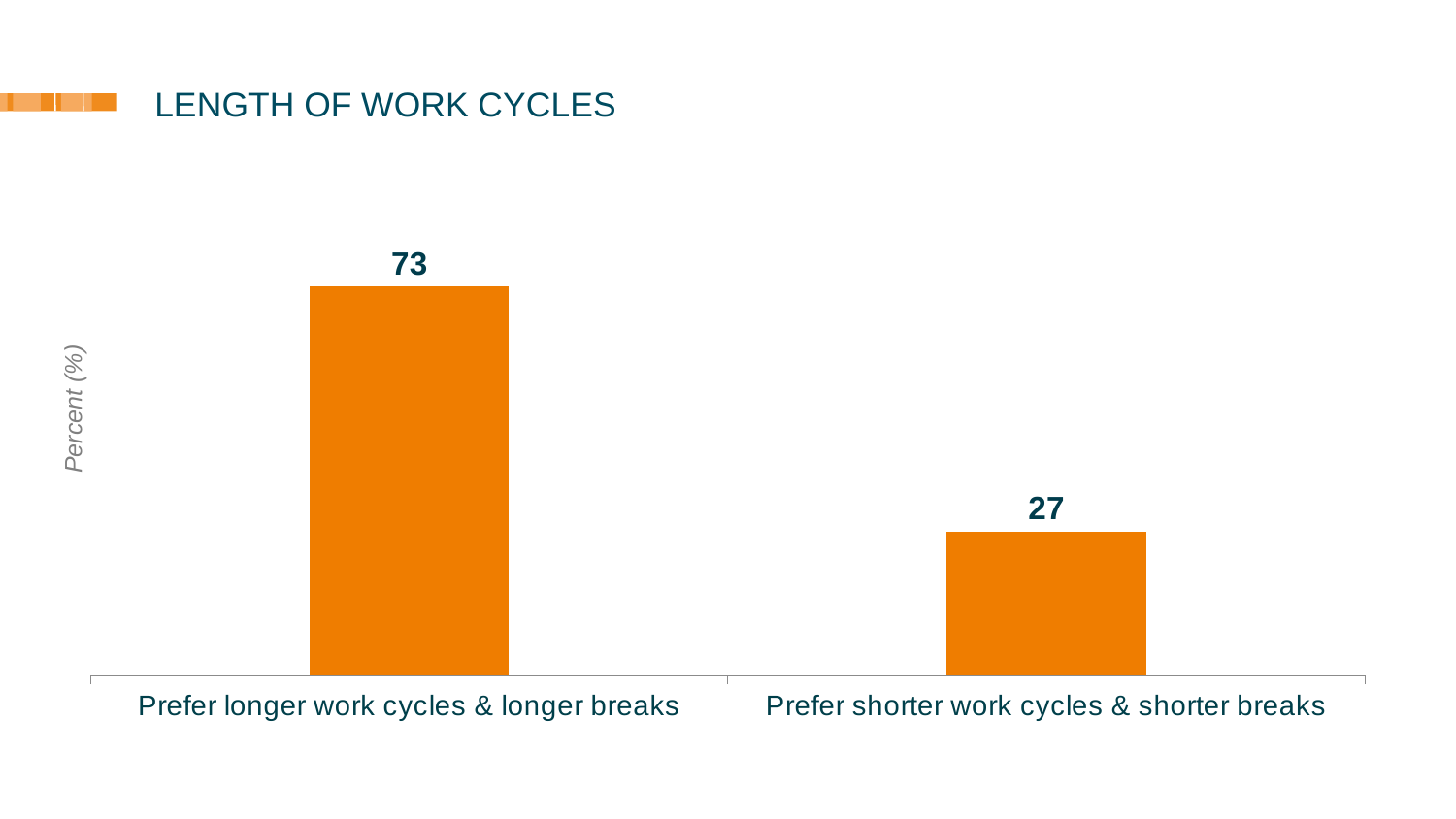
What is the label on the vertical axis? Percent (%) What kind of chart is shown on the slide? Bar chart What is the difference between the values for "Prefer longer work cycles & longer breaks" and "Prefer shorter work cycles & shorter breaks"? 46 What is the title of the slide? LENGTH OF WORK CYCLES What is the value for "Prefer shorter work cycles & shorter breaks"? 27 What is the total of the two values shown in the chart? 100 How many categories are shown in the chart? 2 Which category has the highest value? Prefer longer work cycles & longer breaks Which is larger: the value for "Prefer longer work cycles & longer breaks" or for "Prefer shorter work cycles & shorter breaks"? Prefer longer work cycles & longer breaks Which category has the lowest value? Prefer shorter work cycles & shorter breaks What is the value for "Prefer longer work cycles & longer breaks"? 73